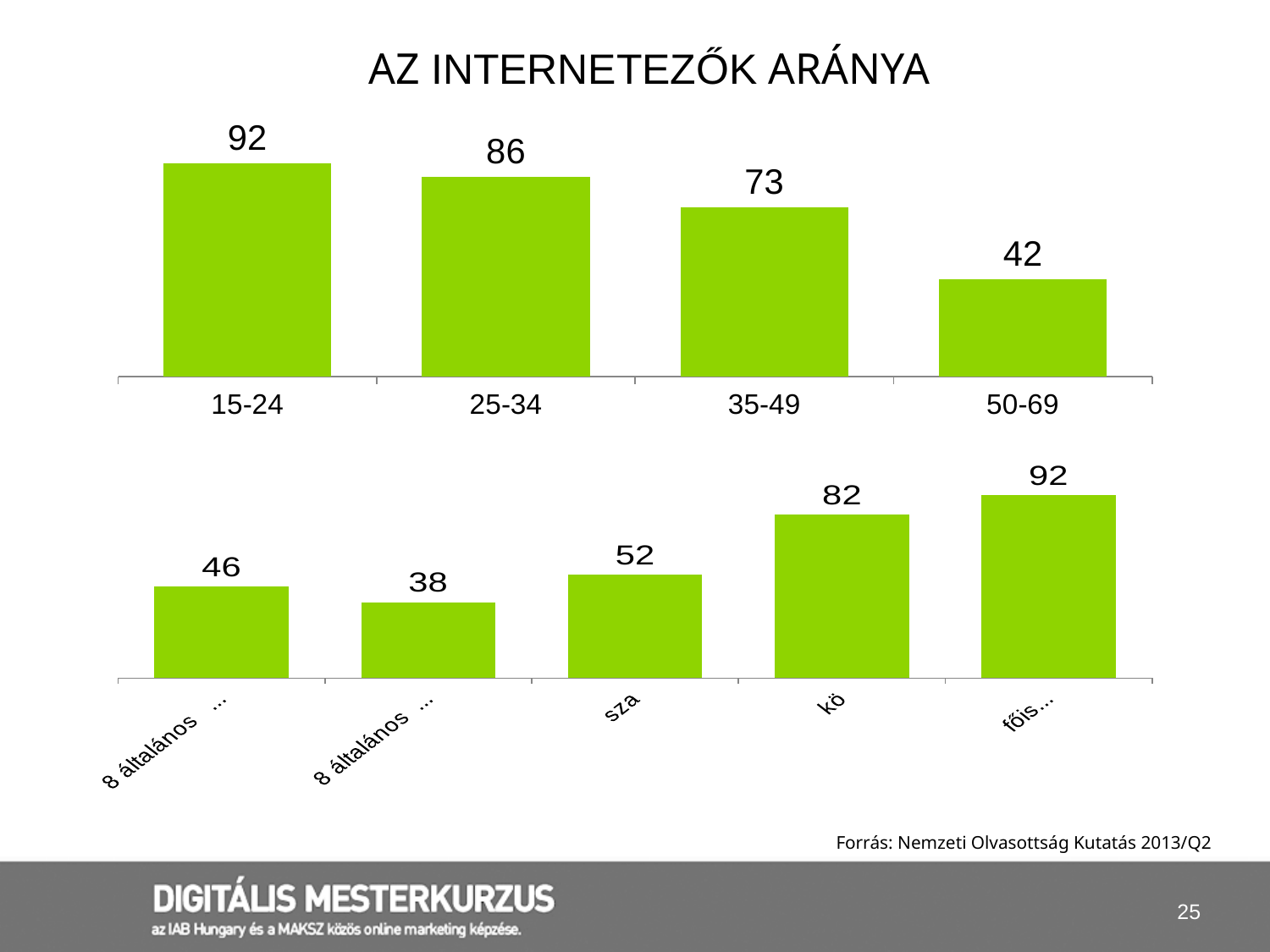
In the top chart (age groups), what is the value for the 15-24 group? 92 In the top chart (age groups), what is the value for the 35-49 group? 73 In the bottom chart, how many bars are shown? 5 In the bottom chart, what is the lowest value shown? 38 In the top chart (age groups), how many age groups are shown? 4 In the top chart (age groups), which is larger: the value for 25-34 or the value for 35-49? 25-34 In the top chart (age groups), which age group has the highest value? 15-24 In the top chart (age groups), what is the difference between the values for 25-34 and 50-69? 44 In the top chart (age groups), do the values rise or fall from left to right along the x axis? fall What kind of chart is the top chart on the slide? bar chart In the top chart (age groups), which age group has the lowest value? 50-69 In the bottom chart, what is the value of the rightmost bar? 92